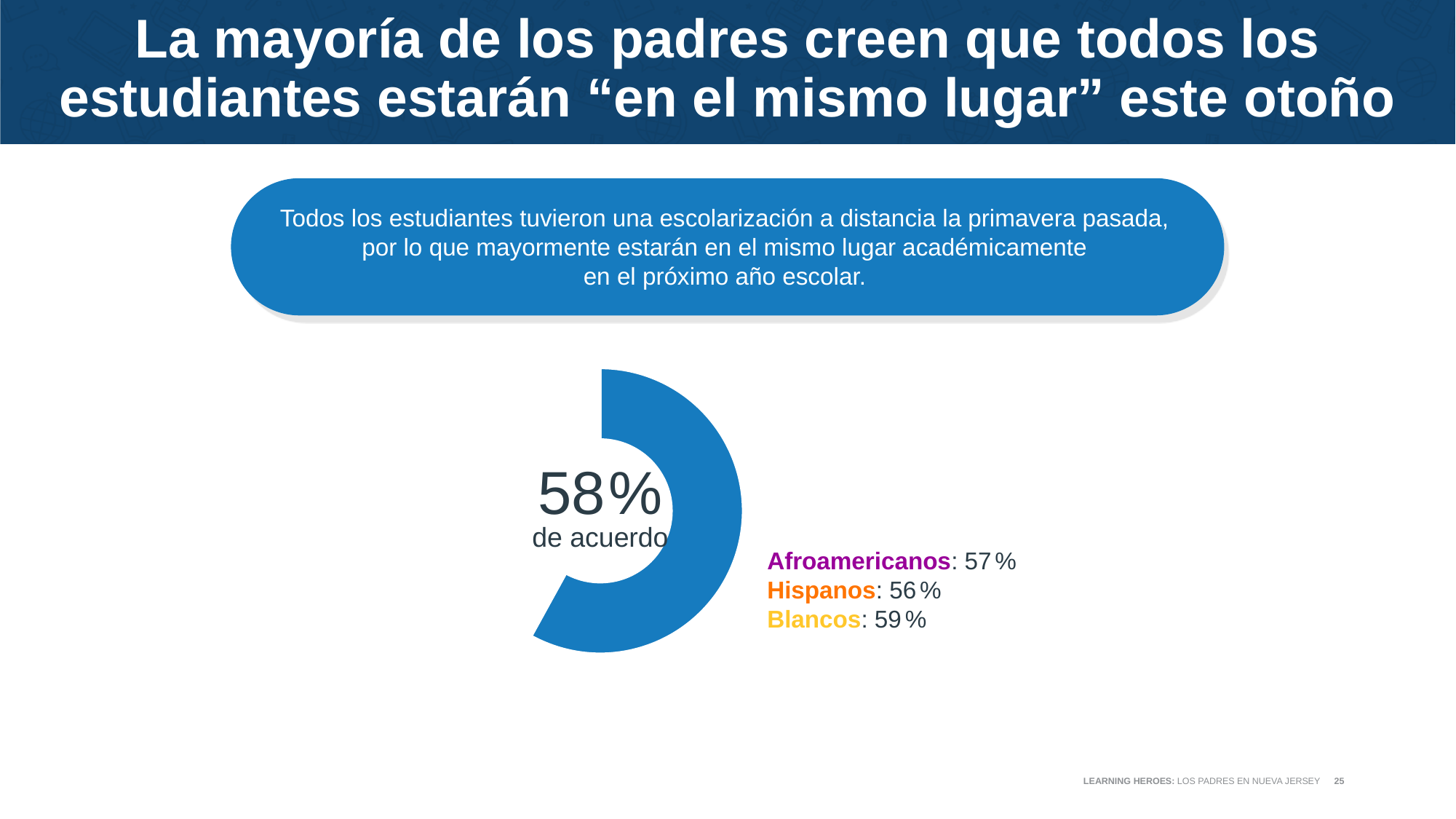
What percentage is shown for Hispanos? 56% What percentage is shown for Afroamericanos? 57% How many demographic groups are listed next to the donut chart? 3 Which group has the lowest percentage in agreement? Hispanos What percentage is shown for Blancos? 59% What label appears under the 58% figure in the centre of the donut chart? de acuerdo What kind of chart is shown on the slide? Donut (pie) chart Which group has the highest percentage in agreement? Blancos Is the overall share of parents in agreement greater or less than 50%? greater Which is larger, the percentage for Afroamericanos or for Hispanos? Afroamericanos What is the difference between the percentages for Blancos and Hispanos? 3% What percentage of parents agree, according to the donut chart? 58%